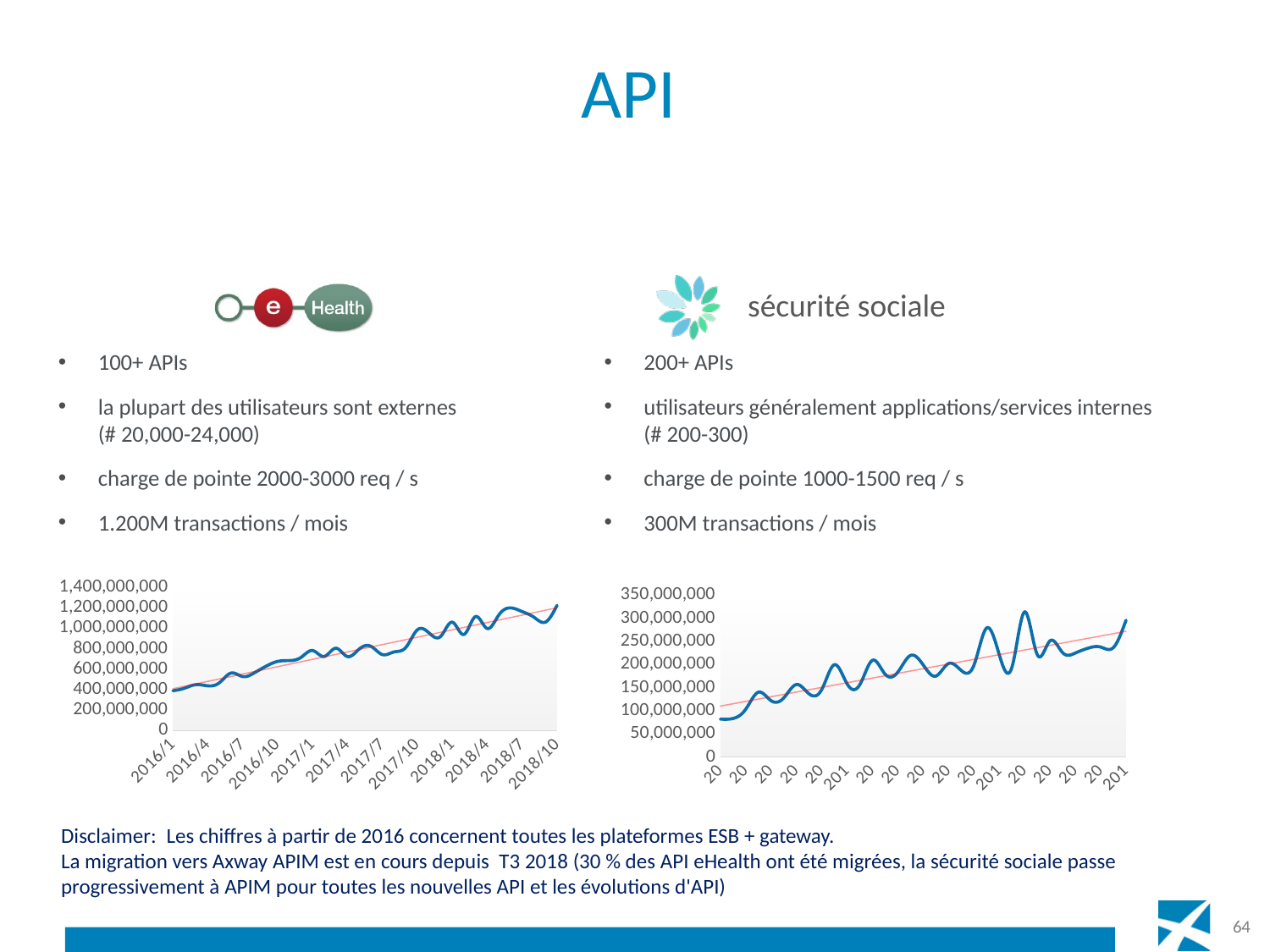
In the right chart (sécurité sociale), is the value at the last point on the x axis greater or less than 250,000,000? greater In the left chart (eHealth), do the values generally rise or fall from 2016/1 to 2018/10? rise How many x-axis tick labels are shown on the left chart (eHealth)? 12 In the right chart (sécurité sociale), is the value at the first point on the x axis greater or less than 100,000,000? less What is the highest value shown on the y axis of the right chart (sécurité sociale)? 350,000,000 What kind of chart is the chart on the left, below the eHealth logo? line chart What is the highest value shown on the y axis of the left chart (eHealth)? 1,400,000,000 In the left chart (eHealth), which x-axis label comes first? 2016/1 In the right chart (sécurité sociale), do the values generally rise or fall along the x axis? rise What kind of chart is the chart on the right, below the sécurité sociale logo? line chart In the left chart (eHealth), is the value at 2018/10 greater or less than 1,000,000,000? greater